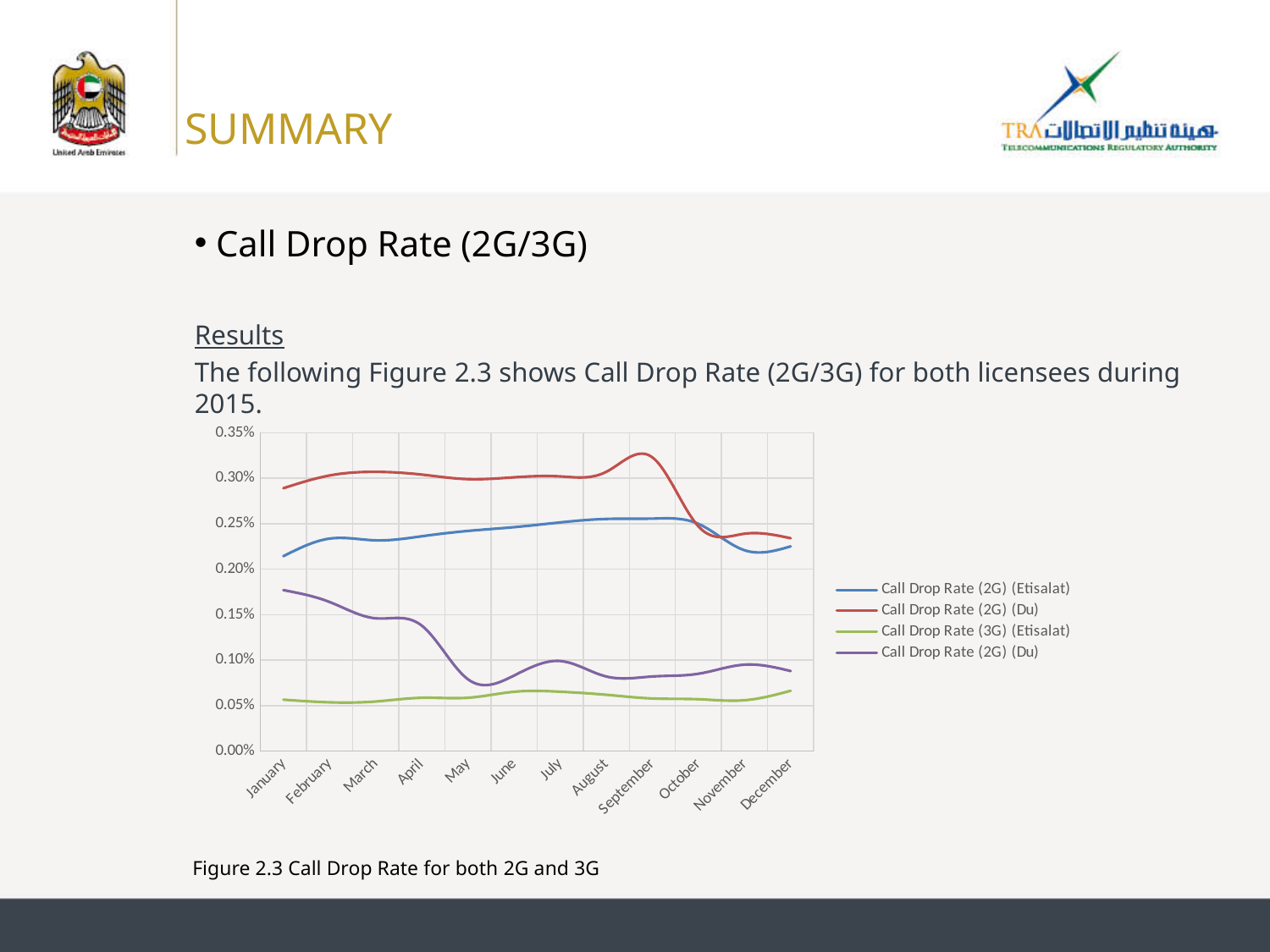
Is the value of the purple line in January greater or less than 0.15%? greater What is the caption given below the chart? Figure 2.3 Call Drop Rate for both 2G and 3G How many series does the chart legend list? 4 Is the value for Call Drop Rate (2G) (Etisalat) in January greater or less than 0.25%? less Does the purple line generally rise or fall from January to May? fall Is the value for Call Drop Rate (3G) (Etisalat) in July greater or less than 0.10%? less How many months are shown along the x axis of the chart? 12 In which month does the Call Drop Rate (2G) (Du) series (red line) reach its highest value? September What kind of chart is shown on the slide? line chart Which series has the lowest values across the whole year? Call Drop Rate (3G) (Etisalat)